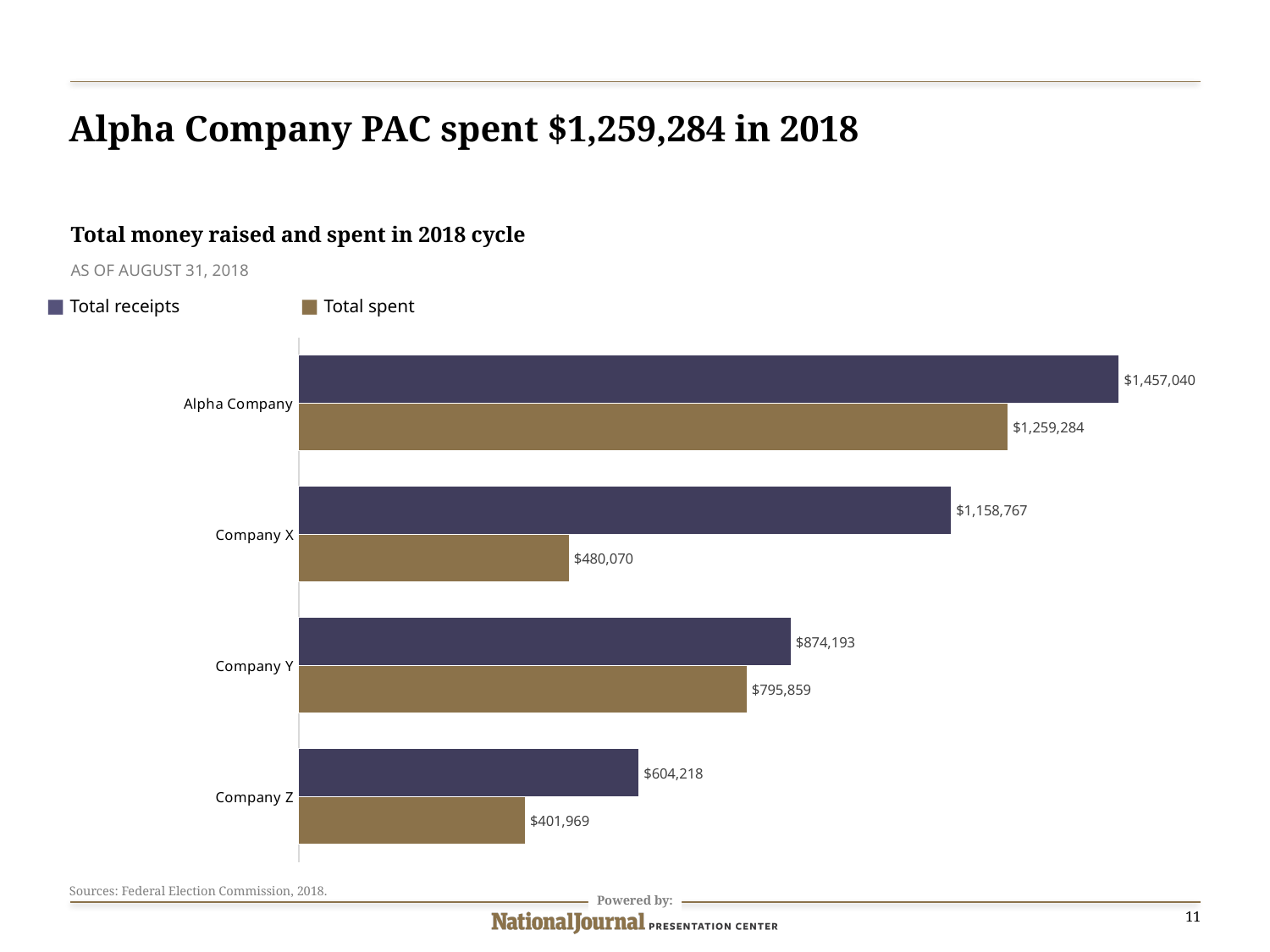
What is the Total spent value for Company Z? $401,969 Which company has the lowest Total spent? Company Z How many companies are shown on the chart? 4 How many series does the legend list? 2 Which is larger, Total spent for Company Y or Total receipts for Company Z? Total spent for Company Y Which company has the highest Total receipts? Alpha Company What is the Total spent value for Company X? $480,070 What is the Total receipts value for Alpha Company? $1,457,040 What kind of chart is shown on the slide? Bar chart What is the difference between Total receipts and Total spent for Company X? $678,697 What is the difference between Total receipts and Total spent for Alpha Company? $197,756 What is the title of the chart? Total money raised and spent in 2018 cycle